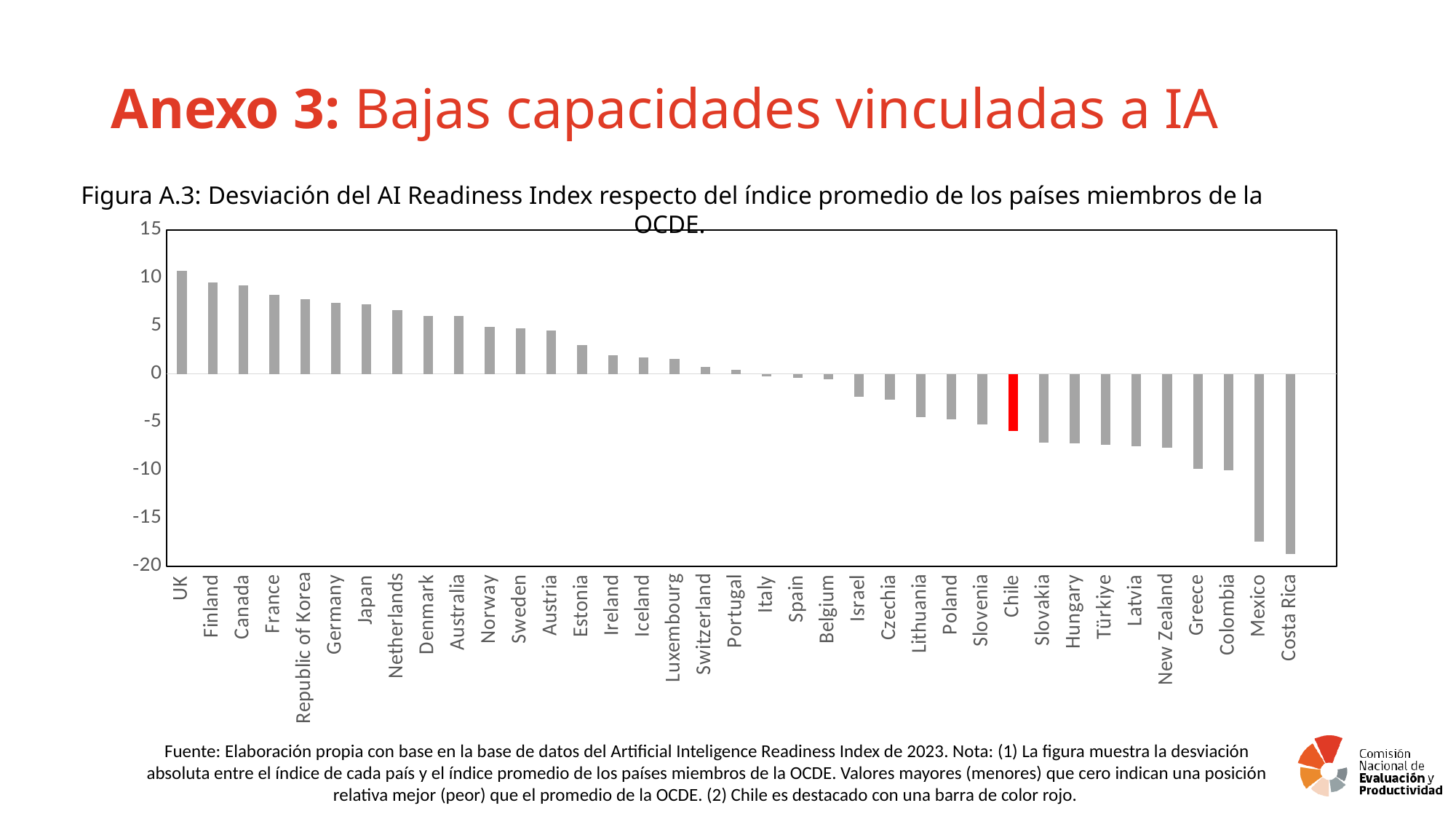
How many countries are shown on the x axis of the chart? 37 Is the value for Israel greater or less than -5? greater Which country's bar is highlighted in red? Chile Is the value for the UK greater or less than 10? greater Is the value for Chile greater or less than -5? less Which country has the highest deviation from the OECD average AI Readiness Index? UK Which country has the lowest deviation from the OECD average AI Readiness Index? Costa Rica Which has the larger value, Japan or Estonia? Japan What kind of chart is shown on the slide? bar chart Do the values rise or fall moving from left to right along the x axis? fall